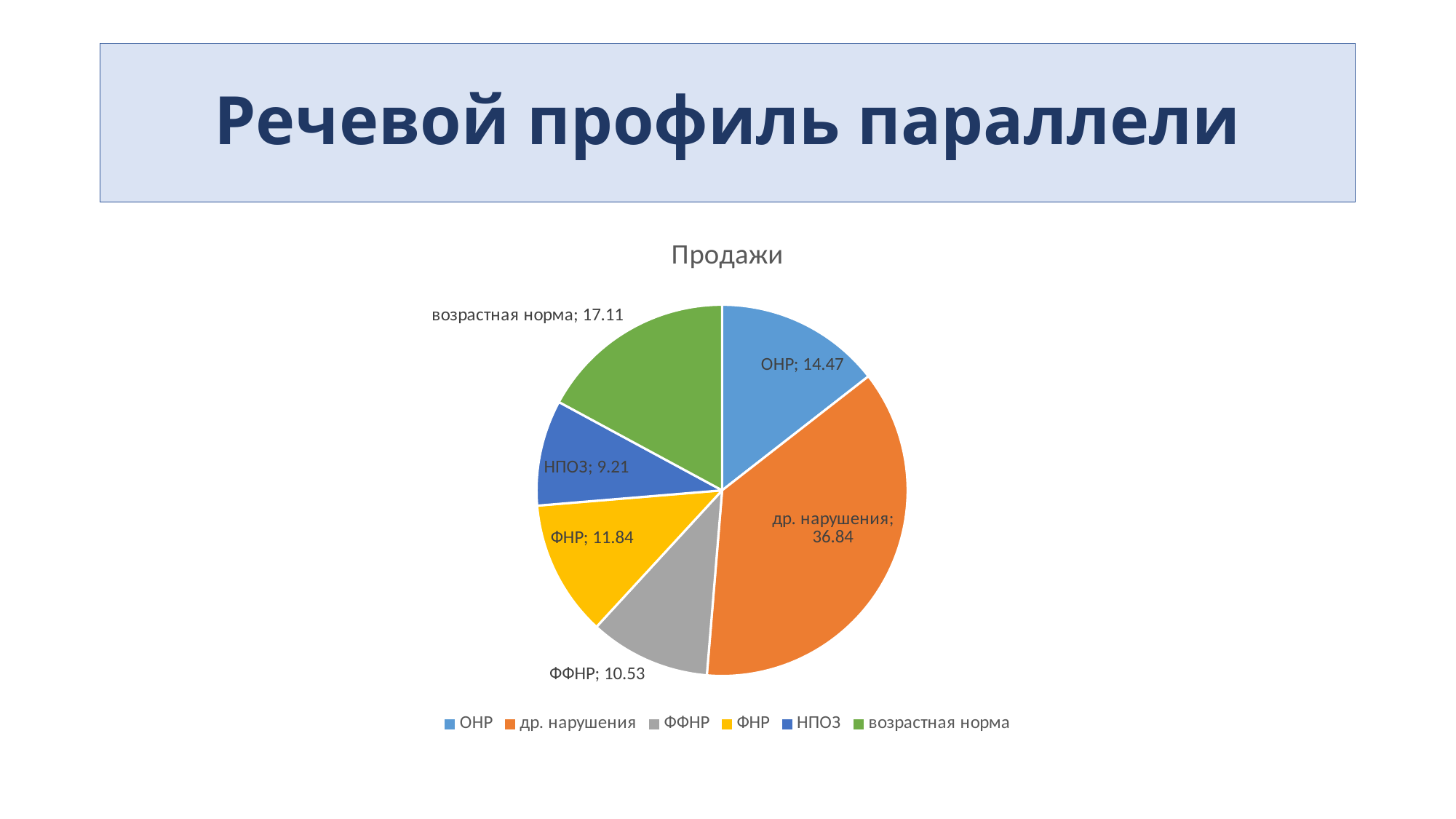
Which is larger, the value for ФНР or the value for ФФНР? ФНР How many slices does the pie chart have? 6 What is the difference between the values for др. нарушения and возрастная норма? 19.73 What is the value for ФФНР? 10.53 Which category has the smallest slice? НПОЗ Which category has the largest slice? др. нарушения What is the value for ОНР? 14.47 What is the value for возрастная норма? 17.11 What type of chart is shown on the slide? pie chart What is the chart's title? Продажи What is the value for др. нарушения? 36.84 What colour is the slice for НПОЗ? dark blue